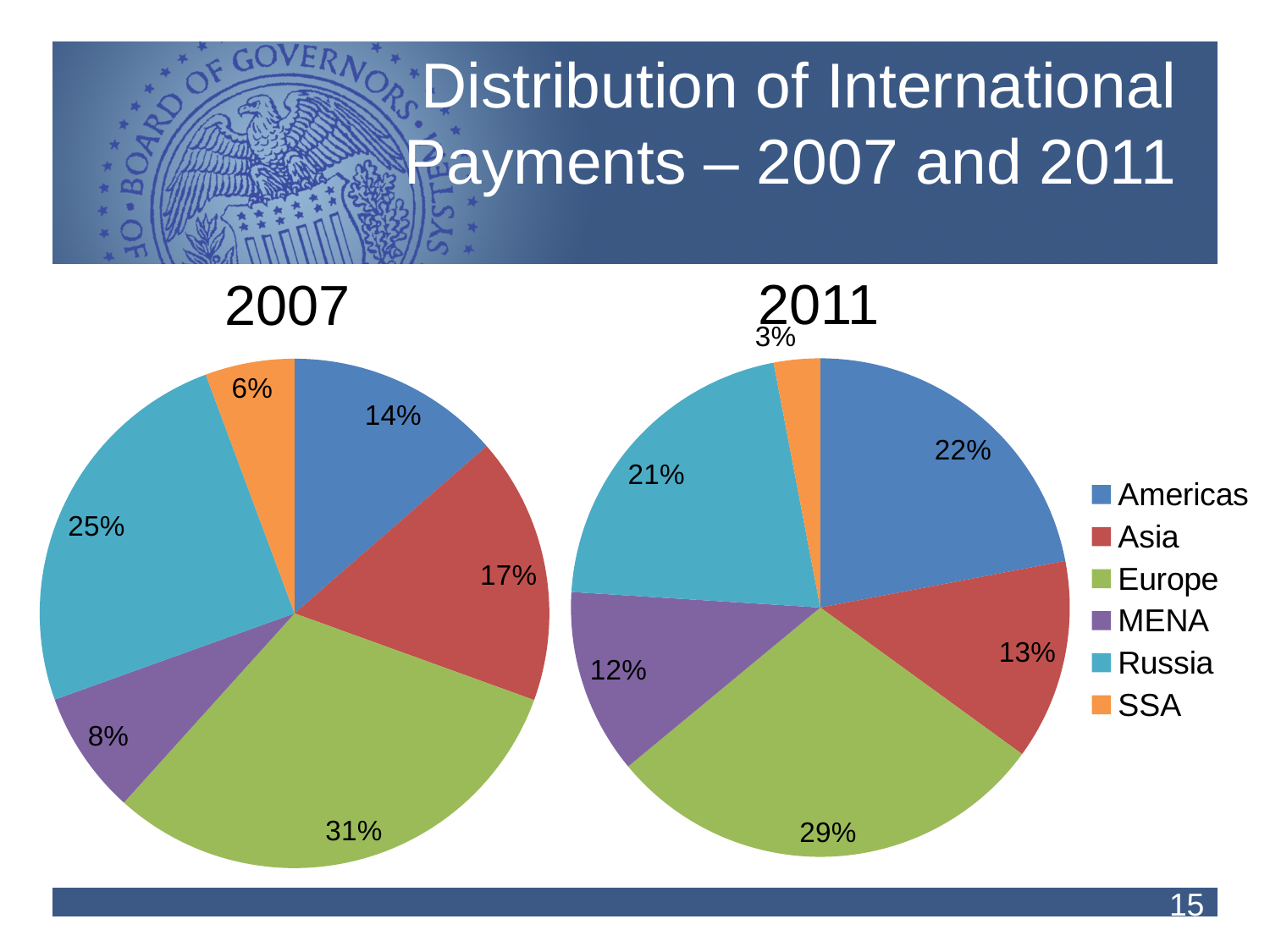
In the 2007 pie chart, which region has the largest share? Europe In the 2007 pie chart, what share does Europe have? 31% In the 2007 pie chart, what share does Russia have? 25% In the 2007 pie chart, which region has the smallest share? SSA What is the difference between the Americas share in 2011 and in 2007? 8% In the 2011 pie chart, which region has the smallest share? SSA What kind of charts are shown on the slide? Pie charts In the 2011 pie chart, what share does SSA have? 3% How many regions does the legend list? 6 In the 2011 pie chart, which is larger, the share for Asia or the share for MENA? Asia Which colour represents Russia in the pie charts? Teal (light blue) In the 2011 pie chart, what share does Americas have? 22%